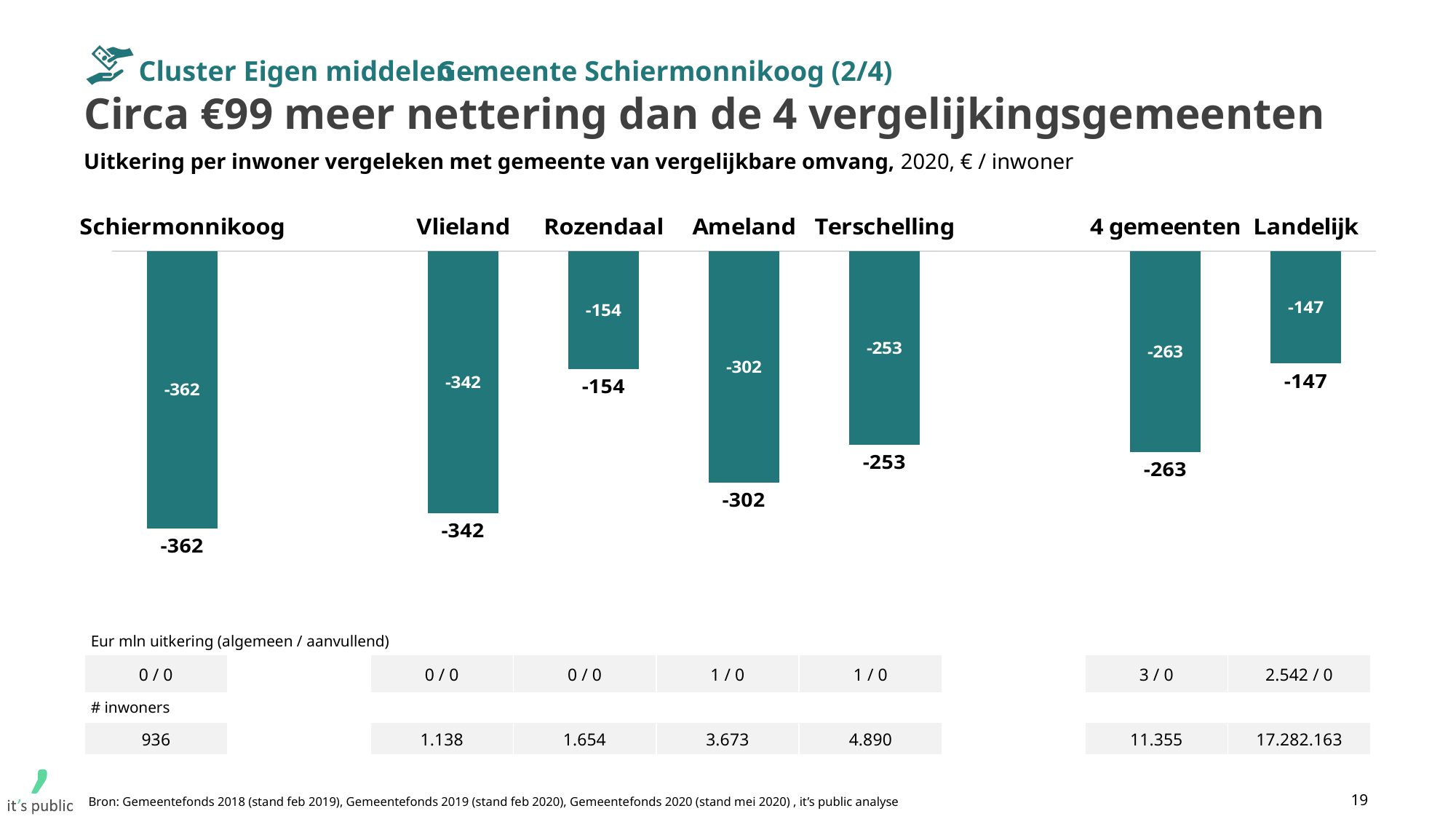
Which bar is longer (more negative): Ameland or Terschelling? Ameland How many bars are plotted in the chart? 7 What is the difference between the values for Vlieland (-342) and Ameland (-302)? 40 What is the value shown for Terschelling? -253 What is the value shown for Vlieland? -342 Which category has the shortest bar (the value closest to zero)? Landelijk What is the value shown for Rozendaal? -154 What kind of chart is shown on the slide? Bar chart What is the difference between the values for Schiermonnikoog (-362) and 4 gemeenten (-263)? 99 What is the value shown for Schiermonnikoog in the chart? -362 What is the value shown for the '4 gemeenten' bar? -263 Which category has the longest bar (the most negative value)? Schiermonnikoog